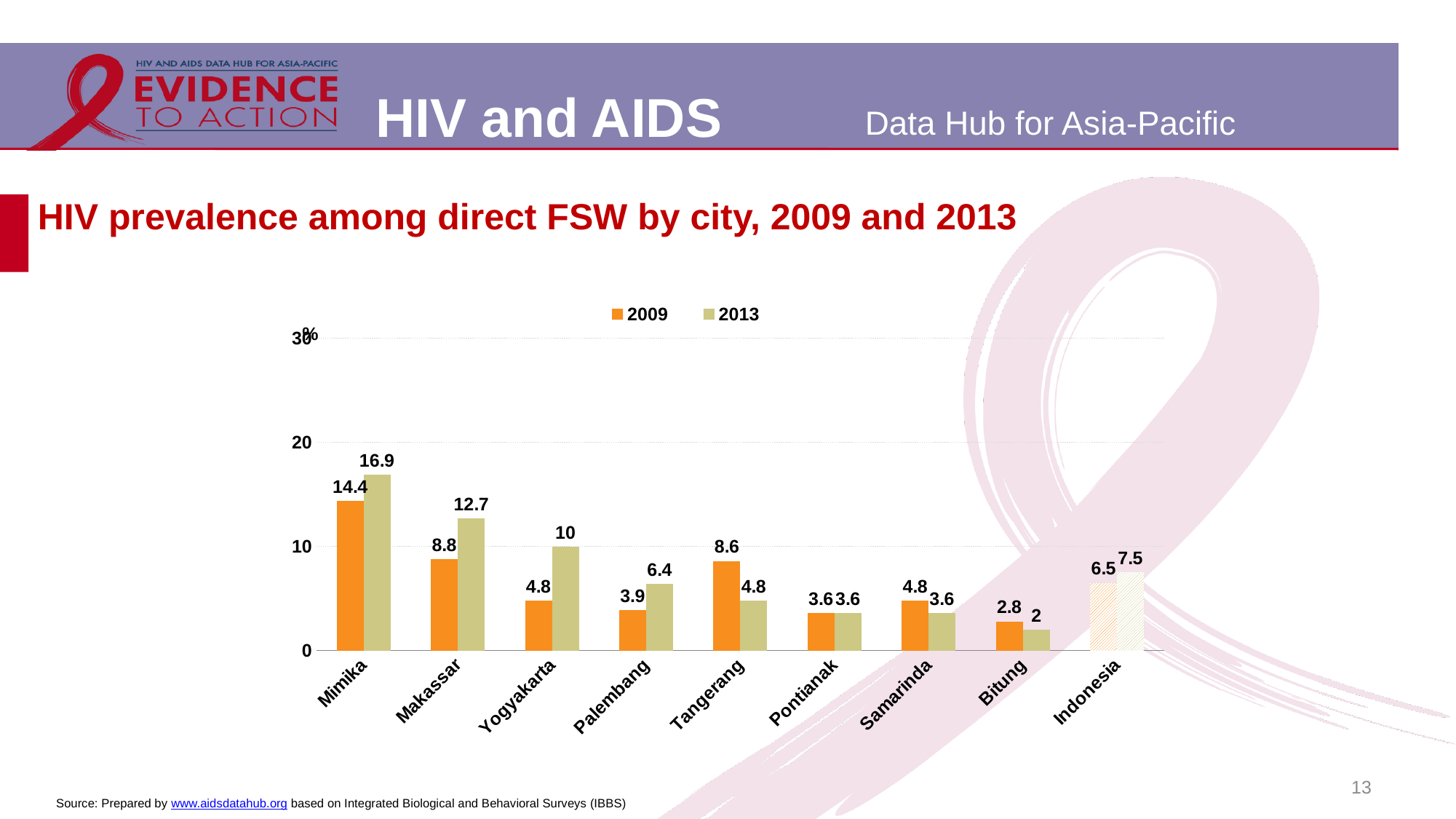
How many cities or regions are shown on the x axis of the chart? 9 Which year had the higher HIV prevalence among direct FSW in Tangerang, 2009 or 2013? 2009 What is the title of the chart on the slide? HIV prevalence among direct FSW by city, 2009 and 2013 What was the HIV prevalence among direct FSW in Mimika in 2013? 16.9 What kind of chart is shown on the slide? Bar chart What is the difference between the 2013 and 2009 HIV prevalence values for Makassar? 3.9 What was the HIV prevalence among direct FSW in Yogyakarta in 2013? 10 Which city had the highest HIV prevalence among direct FSW in 2009? Mimika What was the HIV prevalence among direct FSW in Makassar in 2009? 8.8 Is the 2013 value for Mimika greater or less than 20? less Which city had the lowest HIV prevalence among direct FSW in 2013? Bitung How many series does the legend list? 2